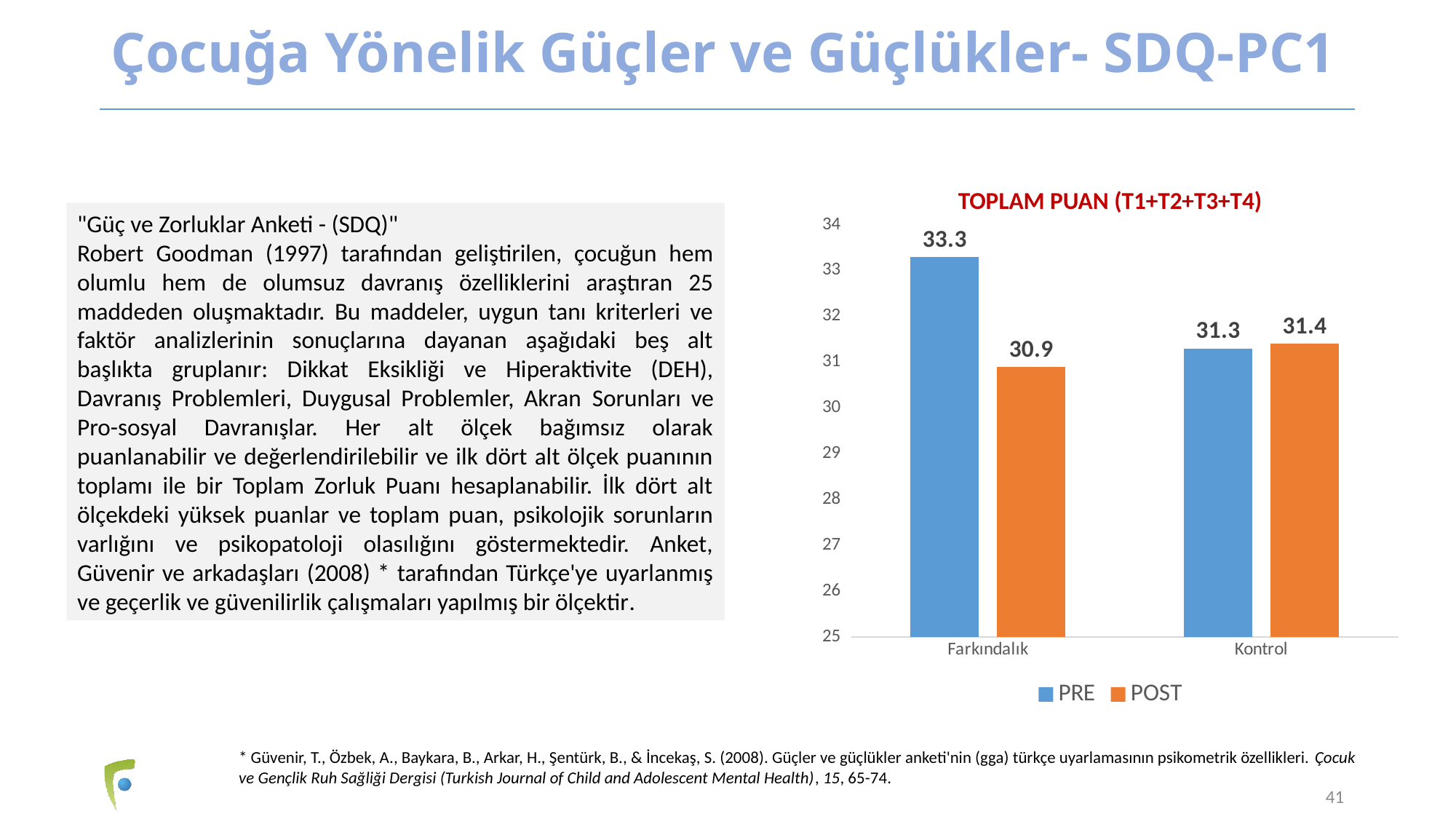
What is the POST value for Kontrol? 31.4 Which bar has the highest value in the chart? Farkındalık PRE What kind of chart is shown on the slide? Bar chart What is the POST value for Farkındalık? 30.9 What is the PRE value for Farkındalık? 33.3 Which is larger: the PRE value for Farkındalık or the PRE value for Kontrol? Farkındalık PRE What is the PRE value for Kontrol? 31.3 How many categories are shown on the x axis? 2 What is the difference between the PRE and POST values for Farkındalık? 2.4 Which bar has the lowest value in the chart? Farkındalık POST What is the title of the chart? TOPLAM PUAN (T1+T2+T3+T4) How many series does the legend list? 2